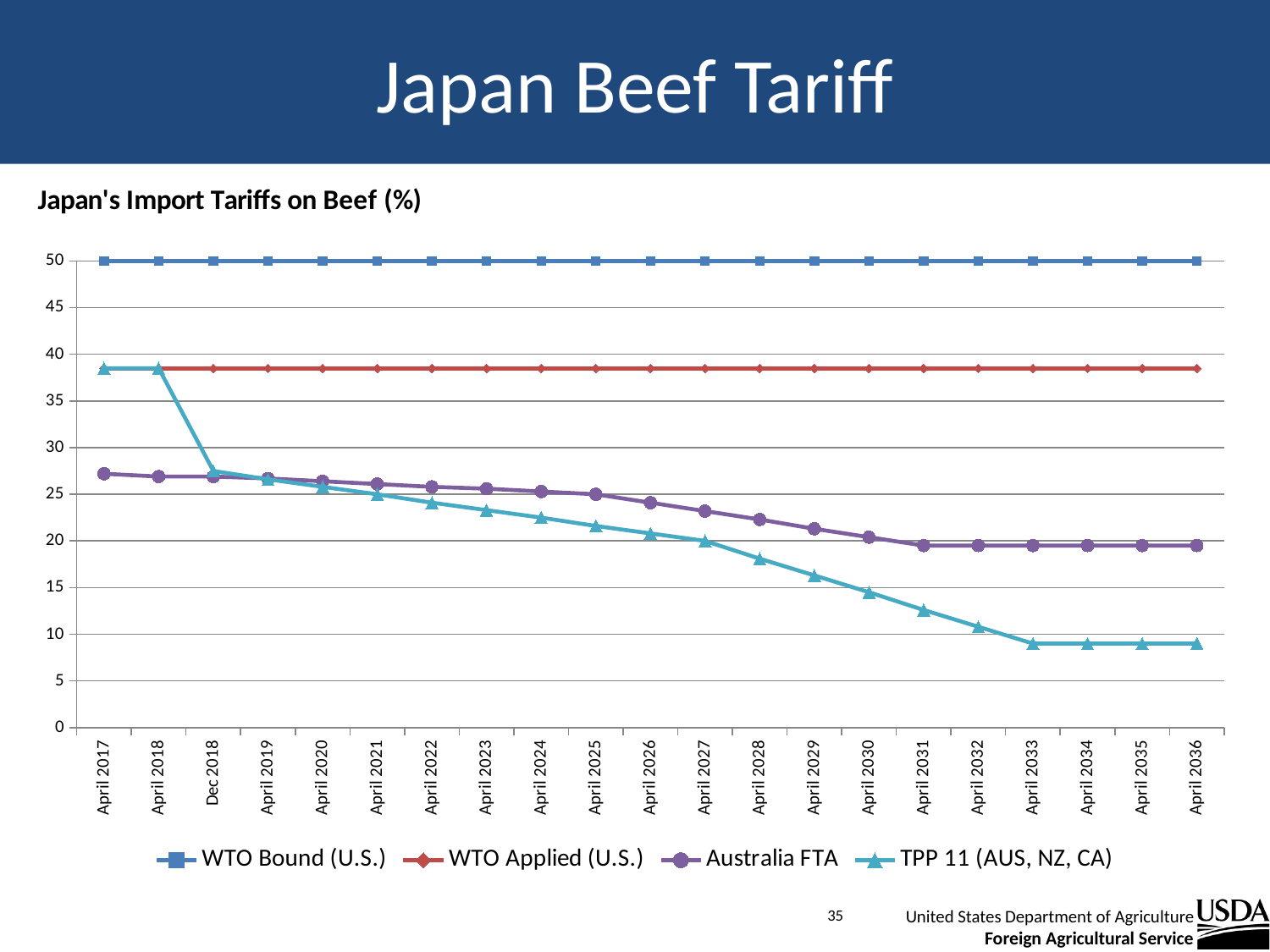
What is the title of the chart? Japan's Import Tariffs on Beef (%) In April 2030, which is larger: Australia FTA or TPP 11 (AUS, NZ, CA)? Australia FTA Does the TPP 11 (AUS, NZ, CA) series rise or fall from April 2017 to April 2036? fall How many time points are shown on the x axis? 21 Is the value for WTO Applied (U.S.) in April 2020 greater or less than 35? greater Is the value for Australia FTA in April 2036 greater or less than 15? greater Is the value for TPP 11 (AUS, NZ, CA) in April 2036 greater or less than 10? less What is the value of WTO Bound (U.S.) in April 2017? 50 How many series does the legend list? 4 What kind of chart is shown on the slide? line chart Which series has the lowest value in April 2036? TPP 11 (AUS, NZ, CA)